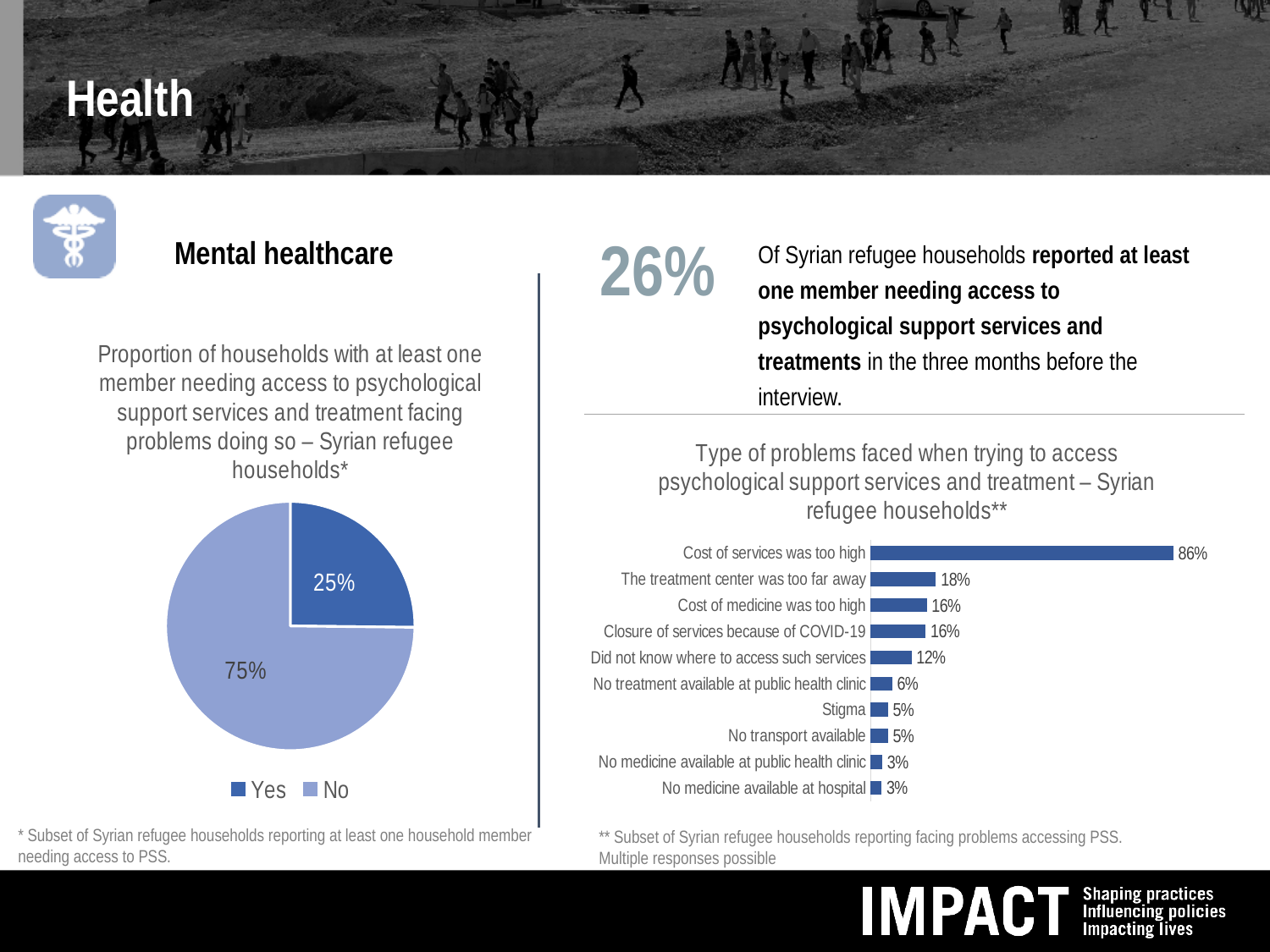
How many entries does the legend of the pie chart on the left list? 2 In the pie chart on the left, which slice is larger, 'Yes' or 'No'? No In the bar chart on the right, what is the difference between 'Cost of services was too high' and 'The treatment center was too far away'? 68% What kind of chart is the chart on the left of the slide? Pie chart How many categories are shown in the bar chart on the right? 10 In the bar chart on the right, what is the value for 'Did not know where to access such services'? 12% What kind of chart is the chart on the right of the slide? Bar chart In the bar chart on the right, which is larger, 'Stigma' or 'No treatment available at public health clinic'? No treatment available at public health clinic In the bar chart on the right, what is the value for 'Cost of services was too high'? 86% In the pie chart on the left, what share of households answered 'Yes'? 25% In the pie chart on the left, what share of households answered 'No'? 75% In the bar chart on the right, which category has the highest value? Cost of services was too high